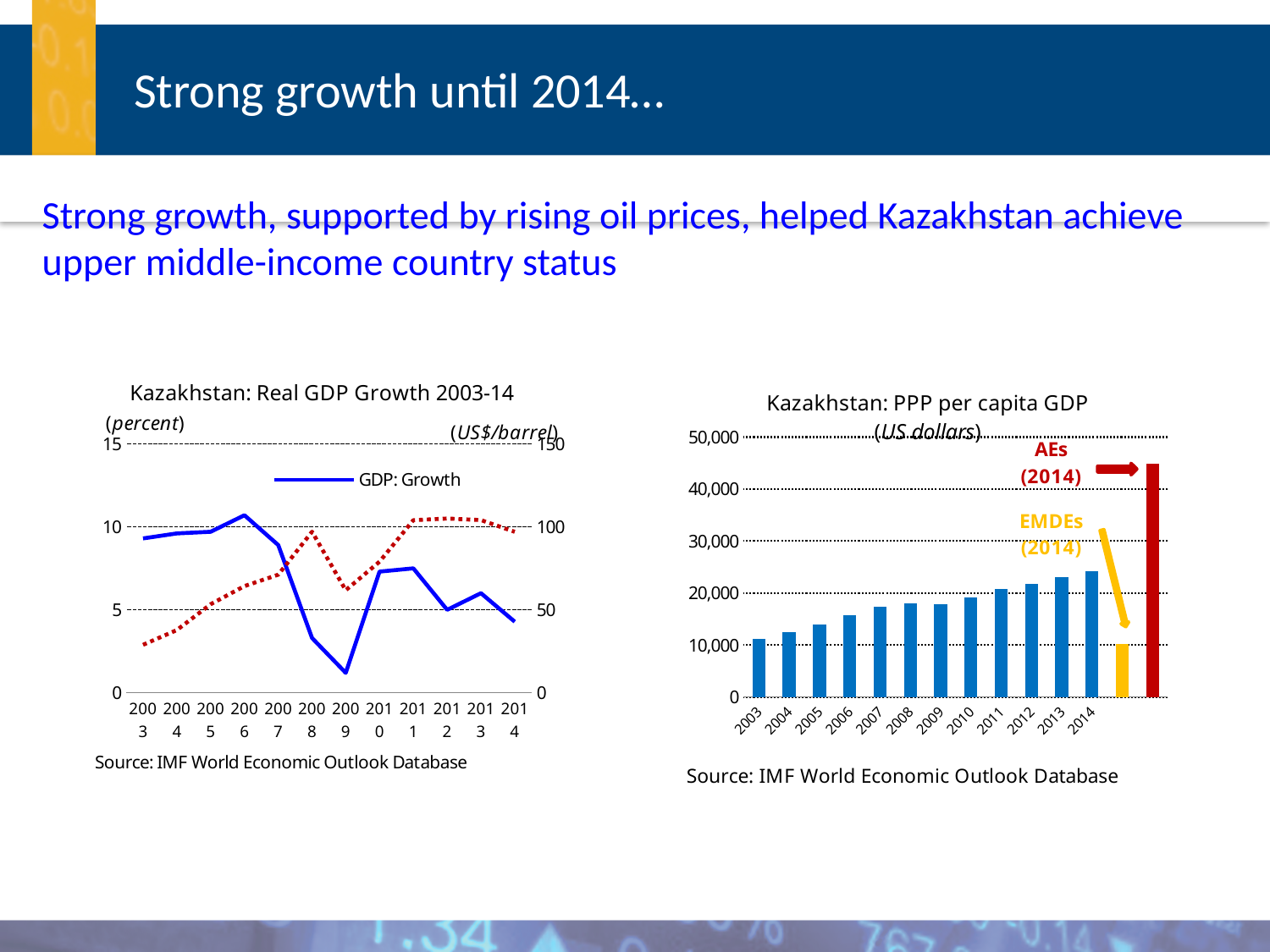
In the right chart 'Kazakhstan: PPP per capita GDP', is the value for 2014 greater or less than 20,000? greater In the right chart 'Kazakhstan: PPP per capita GDP', which is larger, the AEs (2014) bar or the EMDEs (2014) bar? AEs (2014) In the right chart 'Kazakhstan: PPP per capita GDP', do the blue bars generally rise or fall from 2003 to 2014? rise In the right chart 'Kazakhstan: PPP per capita GDP', which year from 2003 to 2014 has the highest blue bar? 2014 What kind of chart is the right chart, 'Kazakhstan: PPP per capita GDP'? bar chart What kind of chart is the left chart, 'Kazakhstan: Real GDP Growth 2003-14'? line chart In the right chart 'Kazakhstan: PPP per capita GDP', is the value for AEs (2014) greater or less than 40,000? greater In the left chart 'Kazakhstan: Real GDP Growth 2003-14', which year has the lowest GDP growth? 2009 In the right chart 'Kazakhstan: PPP per capita GDP', is the value for 2003 greater or less than 20,000? less In the left chart 'Kazakhstan: Real GDP Growth 2003-14', what series name is shown in the legend? GDP: Growth In the right chart 'Kazakhstan: PPP per capita GDP', which year from 2003 to 2014 has the lowest blue bar? 2003